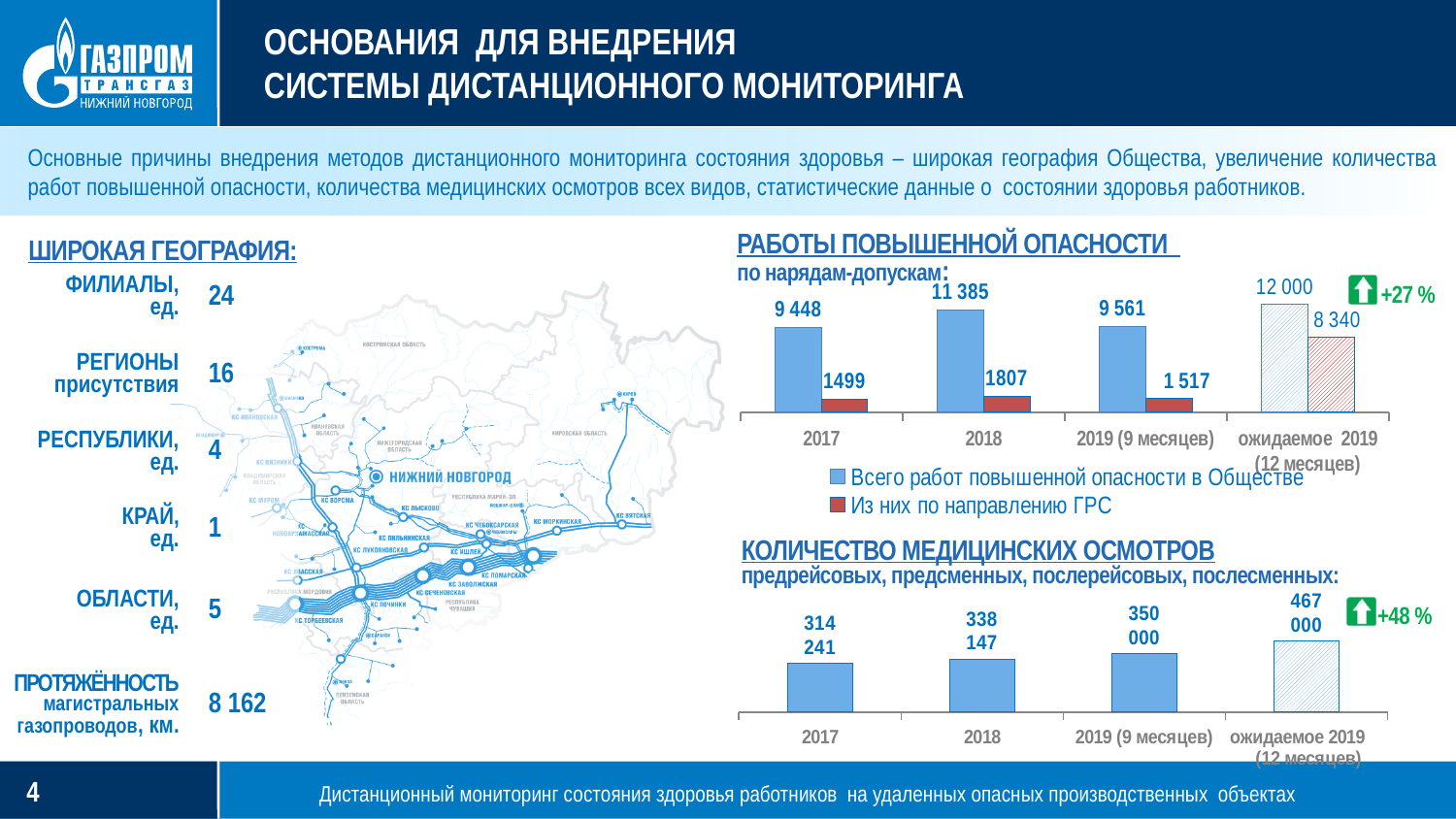
In the 'КОЛИЧЕСТВО МЕДИЦИНСКИХ ОСМОТРОВ' chart, what is the difference between the values for 2019 (9 месяцев) and 2018? 11 853 In the 'РАБОТЫ ПОВЫШЕННОЙ ОПАСНОСТИ' chart, what is the value of 'Из них по направлению ГРС' for 2017? 1499 In the 'РАБОТЫ ПОВЫШЕННОЙ ОПАСНОСТИ' chart, how many categories are shown on the x axis? 4 In the 'КОЛИЧЕСТВО МЕДИЦИНСКИХ ОСМОТРОВ' chart, do the values rise or fall from 2017 to the expected 2019? rise What kind of chart is the 'РАБОТЫ ПОВЫШЕННОЙ ОПАСНОСТИ' chart? bar chart In the 'КОЛИЧЕСТВО МЕДИЦИНСКИХ ОСМОТРОВ' chart, what is the value for 2017? 314 241 In the 'РАБОТЫ ПОВЫШЕННОЙ ОПАСНОСТИ' chart, which category has the highest value for 'Всего работ повышенной опасности в Обществе'? ожидаемое 2019 (12 месяцев) In the 'РАБОТЫ ПОВЫШЕННОЙ ОПАСНОСТИ' chart, how many series does the legend list? 2 In the 'РАБОТЫ ПОВЫШЕННОЙ ОПАСНОСТИ' chart, what is the difference between the 'Всего работ повышенной опасности в Обществе' values for 2018 and 2017? 1 937 In the 'РАБОТЫ ПОВЫШЕННОЙ ОПАСНОСТИ' chart, what is the value of 'Всего работ повышенной опасности в Обществе' for 2018? 11 385 In the 'РАБОТЫ ПОВЫШЕННОЙ ОПАСНОСТИ' chart, what percentage increase is shown next to the expected 2019 bars? +27 % In the 'КОЛИЧЕСТВО МЕДИЦИНСКИХ ОСМОТРОВ' chart, which category has the highest value? ожидаемое 2019 (12 месяцев)